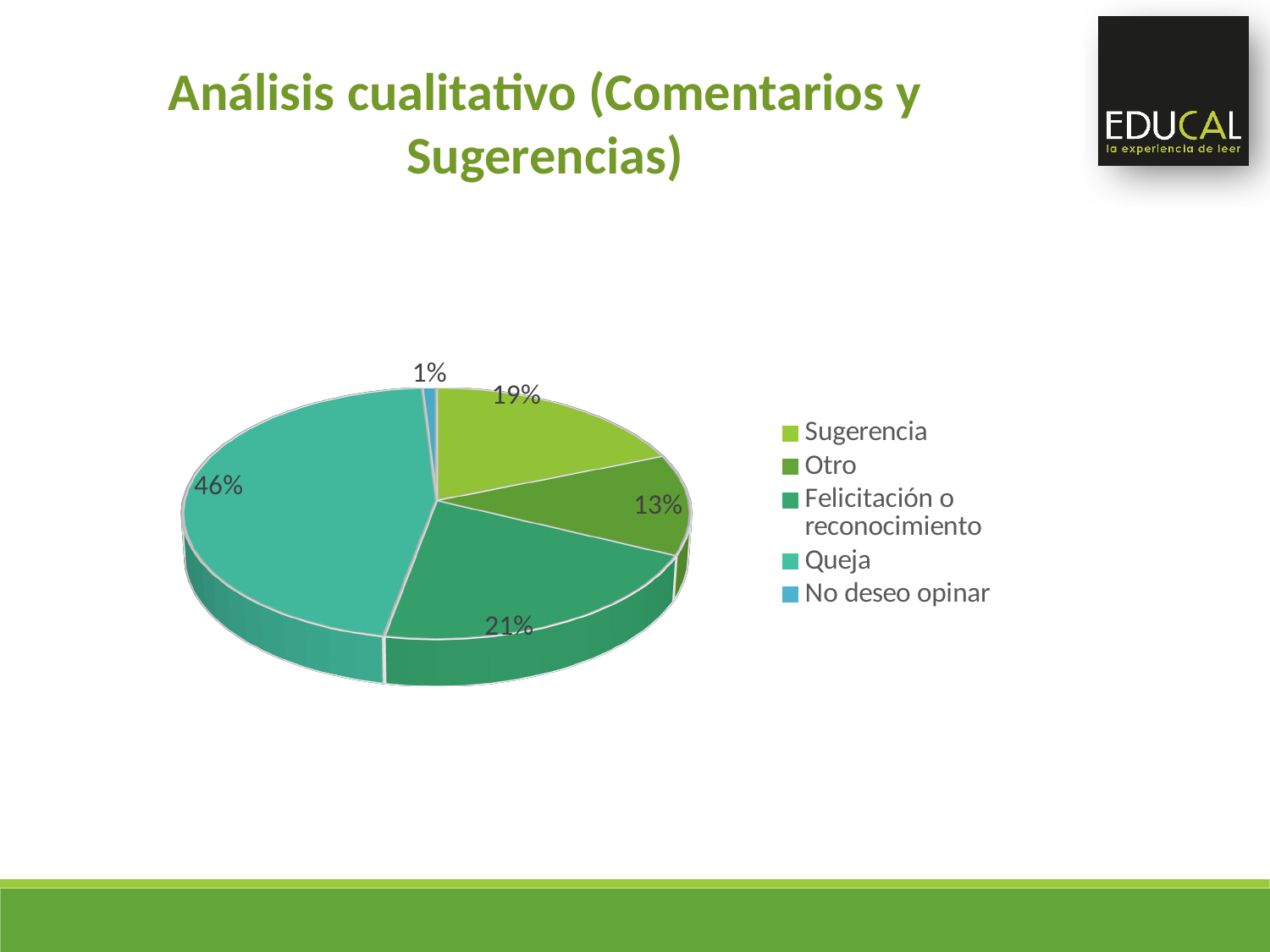
What share of the pie does Felicitación o reconocimiento represent? 21% What share of the pie does No deseo opinar represent? 1% Which is larger, the share for Sugerencia or the share for Otro? Sugerencia What is the title of the slide containing the chart? Análisis cualitativo (Comentarios y Sugerencias) What share of the pie does Queja represent? 46% How many categories does the legend list? 5 Which category has the smallest slice of the pie? No deseo opinar What is the difference in percentage points between Queja and Felicitación o reconocimiento? 25 What kind of chart is shown on the slide? pie chart Which category has the largest slice of the pie? Queja